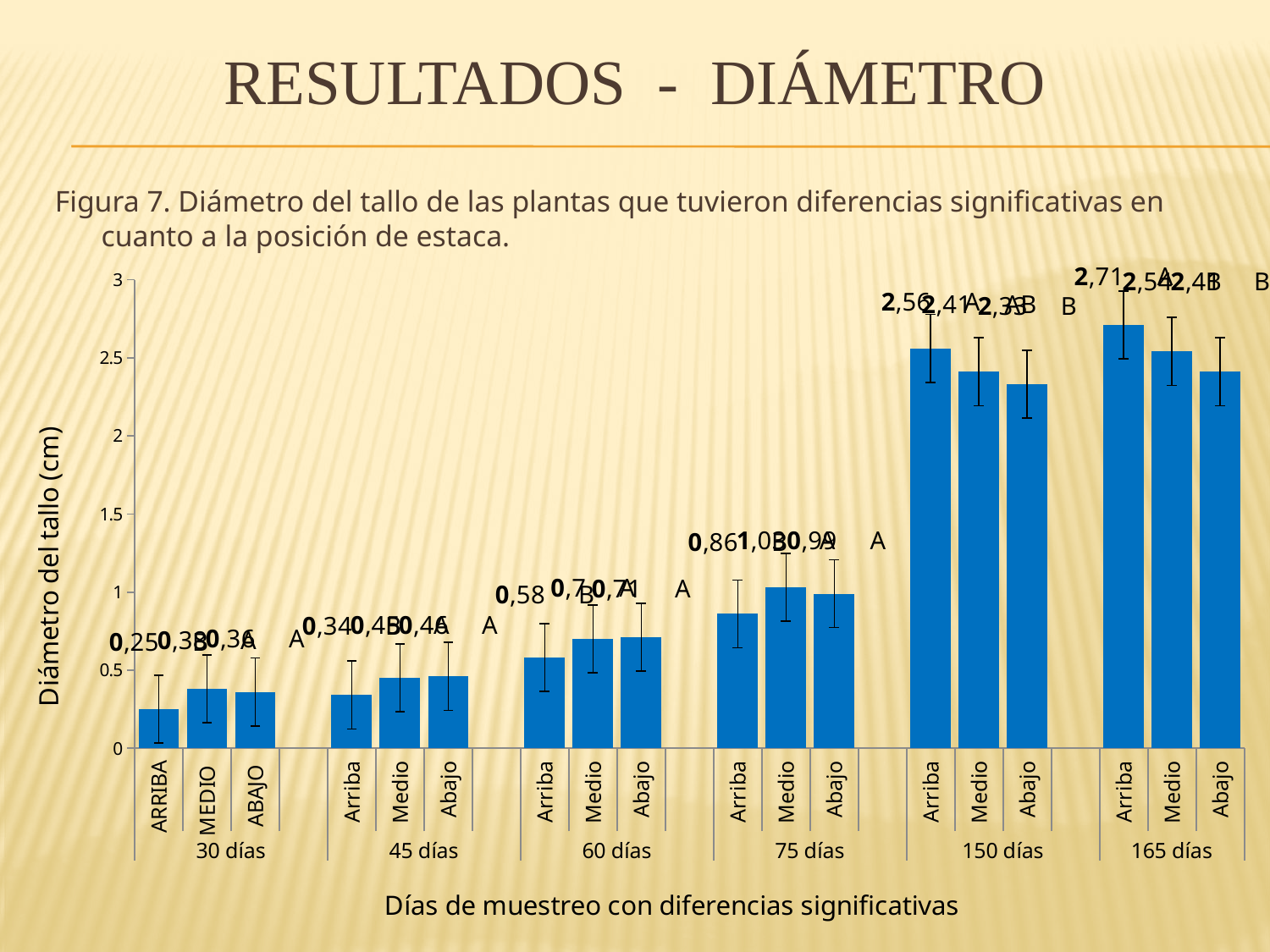
What is the value for Arriba at 75 días? 0,86 Which bar has the lowest value in the chart? ARRIBA at 30 días Is the value for Abajo at 150 días greater or less than 2? greater How many sampling-day groups are shown on the x axis? 6 What is the difference between the Arriba values at 165 días and 150 días? 0,15 What is the stem diameter value for Arriba at 165 días? 2,71 What is the stem diameter value for Arriba at 150 días? 2,56 Which bar has the highest value in the chart? Arriba at 165 días What is the value for ARRIBA at 30 días? 0,25 What is the value for Arriba at 60 días? 0,58 What is the title of the y axis? Diámetro del tallo (cm) What type of chart is shown on the slide? Bar chart